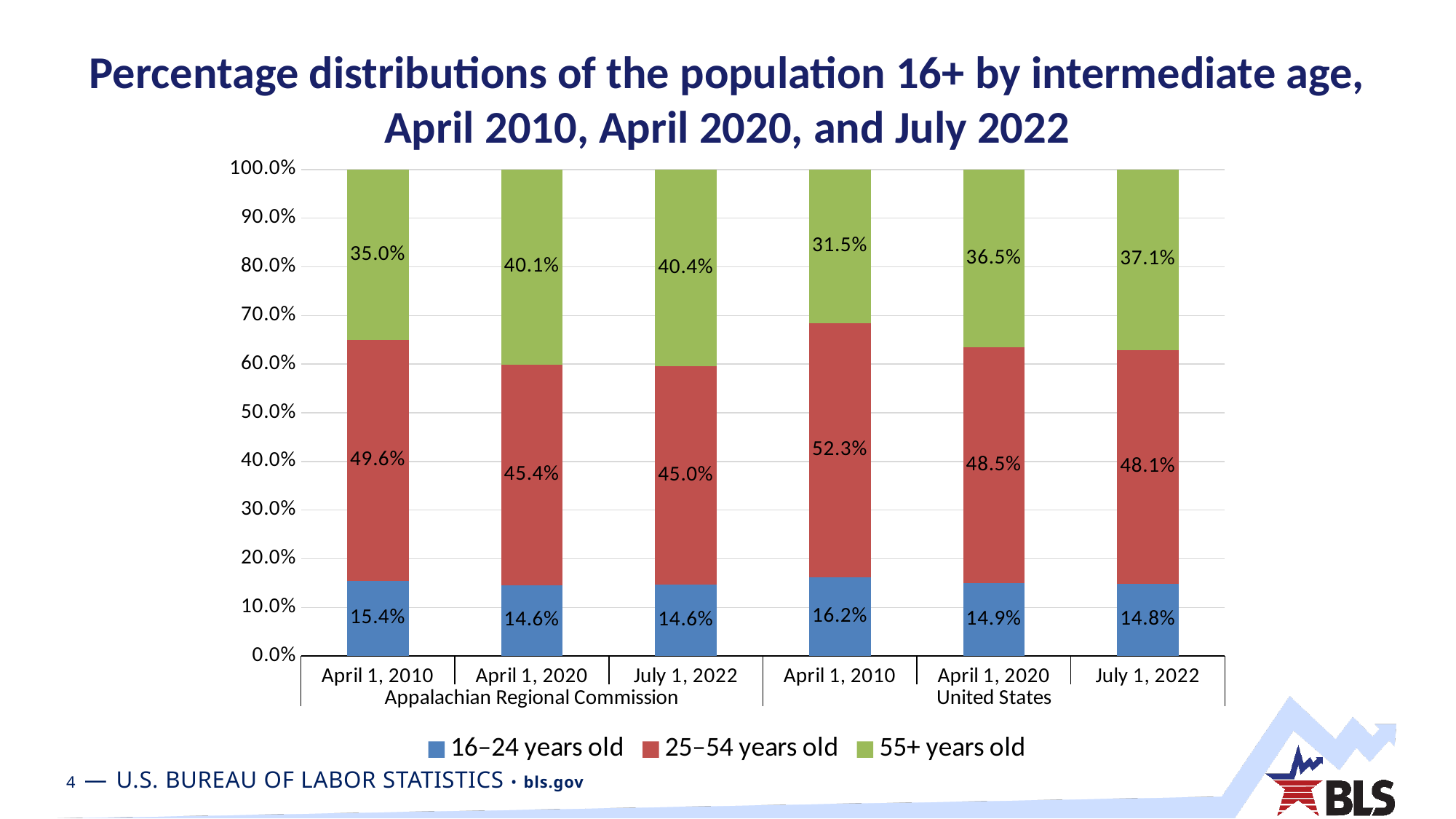
How many bars are shown in the chart? 6 Which bar has the lowest value for 55+ years old? April 1, 2010, United States How many series does the legend list? 3 What is the value for 25–54 years old in the United States on April 1, 2010? 52.3% What kind of chart is shown on the slide? Stacked bar chart Does the 55+ years old share for the Appalachian Regional Commission rise or fall from April 1, 2010 to July 1, 2022? Rises On April 1, 2020, which had the larger 55+ years old share: the Appalachian Regional Commission or the United States? Appalachian Regional Commission What is the total of the stacked bar for the Appalachian Regional Commission on April 1, 2010? 100.0% What percentage of the Appalachian Regional Commission population on April 1, 2010 was 55+ years old? 35.0% Which bar has the highest value for 55+ years old? July 1, 2022, Appalachian Regional Commission What is the value for 16–24 years old in the United States on July 1, 2022? 14.8% What is the difference between the 25–54 years old values for the Appalachian Regional Commission on April 1, 2010 and July 1, 2022? 4.6 percentage points